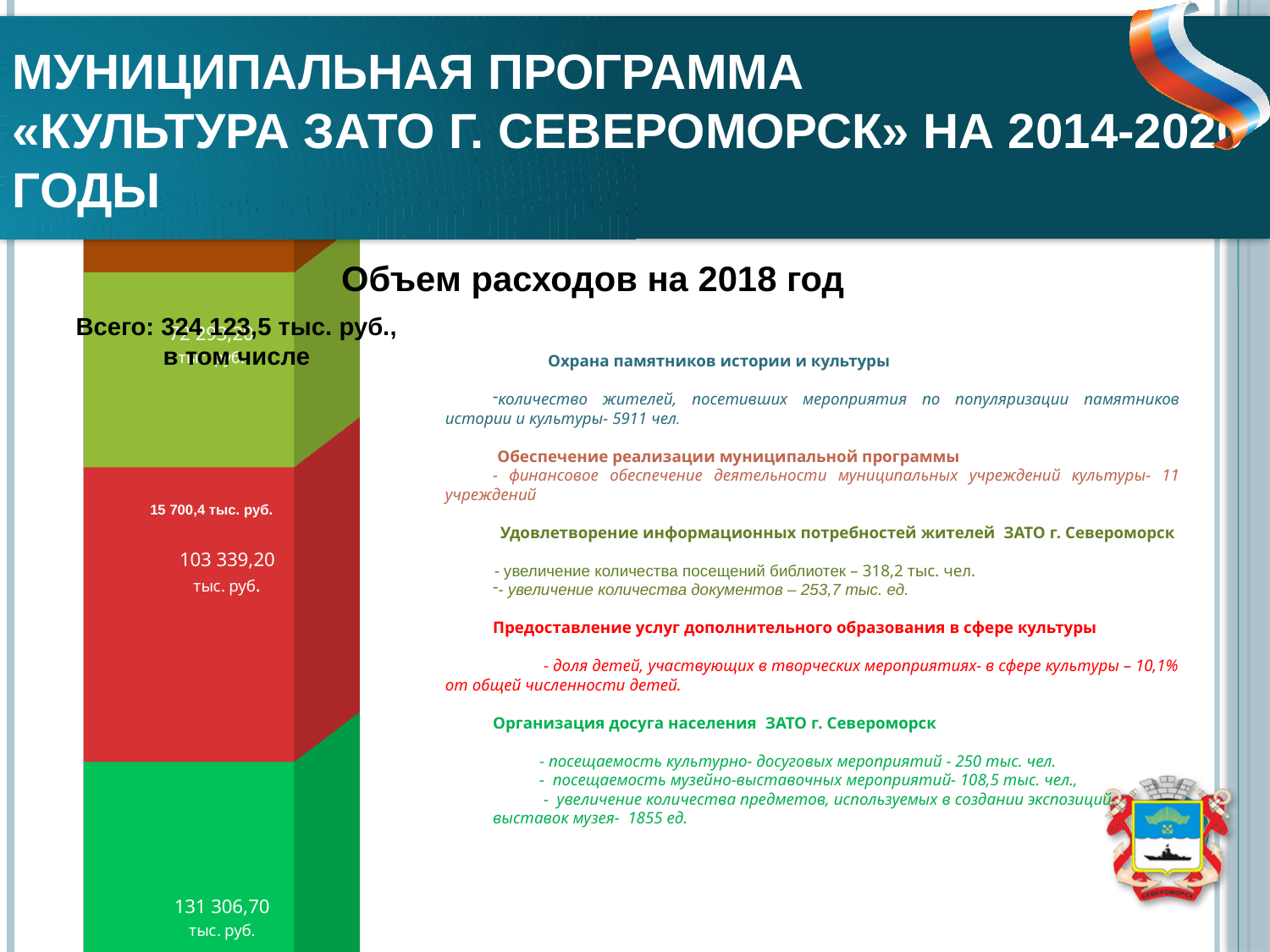
Which segment is smallest: the orange top segment or the bottom dark green segment? the orange top segment Which segment of the stacked bar is the largest? the bottom dark green segment (131 306,70 тыс. руб.) What value is printed on the bottom (dark green) segment of the stacked bar? 131 306,70 тыс. руб. What value is printed in the red segment of the stacked bar? 103 339,20 тыс. руб. What is the title of the chart section on the slide? Объем расходов на 2018 год What total amount of expenditure for 2018 is stated above the chart? 324 123,5 тыс. руб. Is the value of the red segment greater or less than 100 000 тыс. руб.? greater Which is larger: the bottom dark green segment or the red segment of the bar? the bottom dark green segment What is the difference between the bottom dark green segment (131 306,70) and the red segment (103 339,20)? 27 967,50 тыс. руб. What kind of chart is shown on the left of the slide? bar chart What colour is the topmost segment of the stacked bar? orange